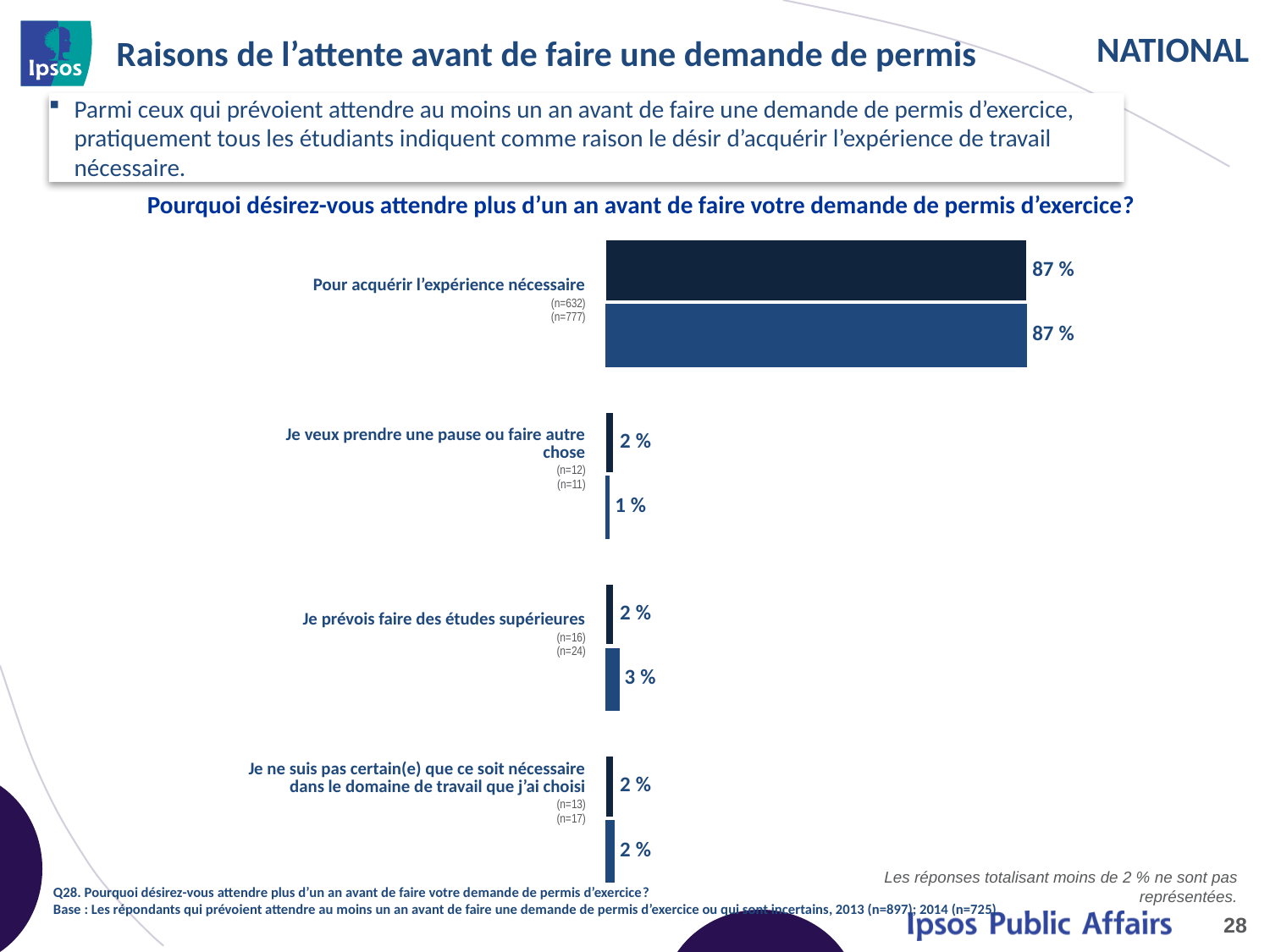
What is the difference between the dark navy (top) bar for "Pour acquérir l'expérience nécessaire" and the dark navy (top) bar for "Je veux prendre une pause ou faire autre chose"? 85 percentage points For "Je prévois faire des études supérieures", which bar is larger, the dark navy (top) bar or the lighter blue (bottom) bar? The lighter blue (bottom) bar What is the value of the dark navy (top) bar for "Je ne suis pas certain(e) que ce soit nécessaire dans le domaine de travail que j'ai choisi"? 2 % What is the title of the chart? Pourquoi désirez-vous attendre plus d'un an avant de faire votre demande de permis d'exercice? How many bars are shown for each reason category? 2 What is the value of the dark navy (top) bar for "Pour acquérir l'expérience nécessaire"? 87 % What is the value of the lighter blue (bottom) bar for "Je veux prendre une pause ou faire autre chose"? 1 % What is the value of the lighter blue (bottom) bar for "Je prévois faire des études supérieures"? 3 % For "Je veux prendre une pause ou faire autre chose", what is the difference between the dark navy (top) bar and the lighter blue (bottom) bar? 1 percentage point How many reason categories are shown in the chart? 4 Which reason has the highest value in the chart? Pour acquérir l'expérience nécessaire What type of chart is shown on the slide? Bar chart